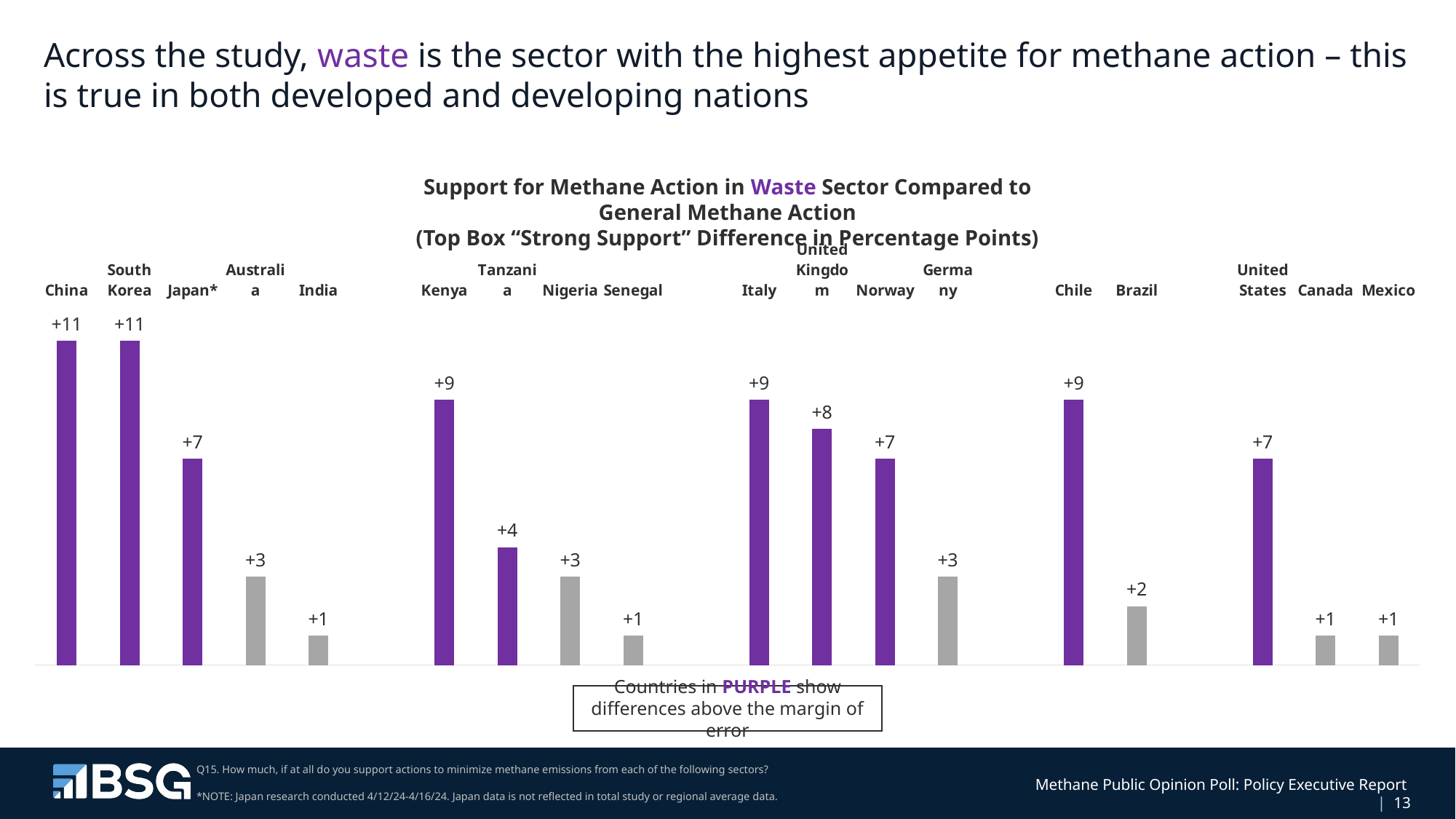
What is the highest value shown on the chart? +11 Which has a larger value, Chile or Mexico? Chile What is the value shown for Brazil? +2 How many countries are shown on the chart? 18 Which has a larger value, Norway or Nigeria? Norway What is the difference between the values for Japan* and Australia? 4 What is the value shown for Tanzania? +4 What is the difference between the values for Italy and Germany? 6 What kind of chart is shown on the slide? Bar chart What is the value shown for the United Kingdom? +8 What is the value shown for Kenya? +9 What is the value shown for China? +11